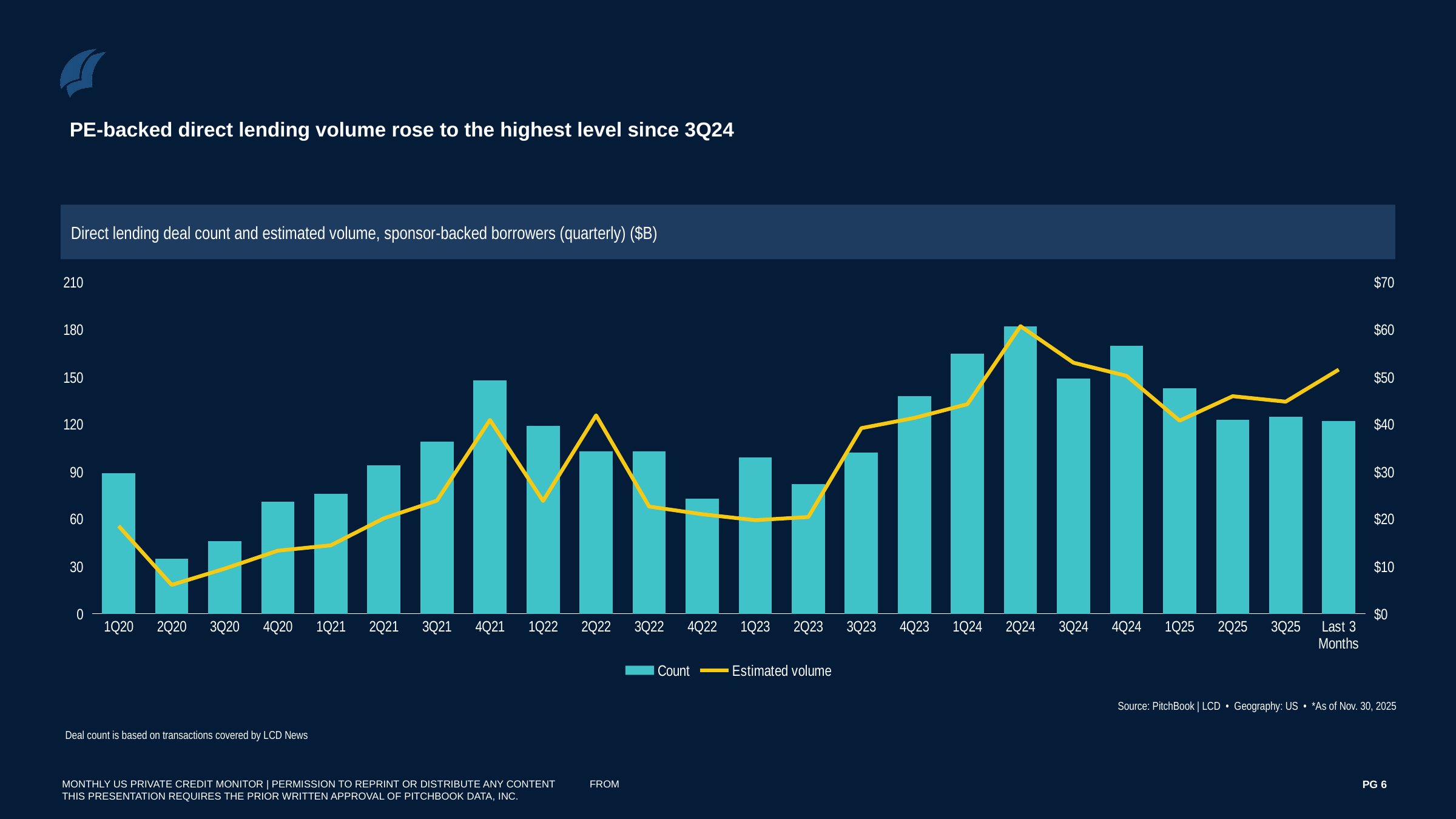
Which has the larger deal count, 4Q21 or 1Q22? 4Q21 Is the estimated volume for the Last 3 Months greater or less than $50? greater Is the estimated volume for 2Q20 greater or less than $10? less Is the deal count for 1Q25 greater or less than 150? less How many series does the legend list? 2 Which quarter has the lowest deal count? 2Q20 Which quarter has the lowest estimated volume? 2Q20 Which quarter has the highest deal count? 2Q24 What kind of chart is this? Combined bar and line chart Does the deal count rise or fall from 2Q20 to 4Q21? rise How many categories are shown on the x axis? 24